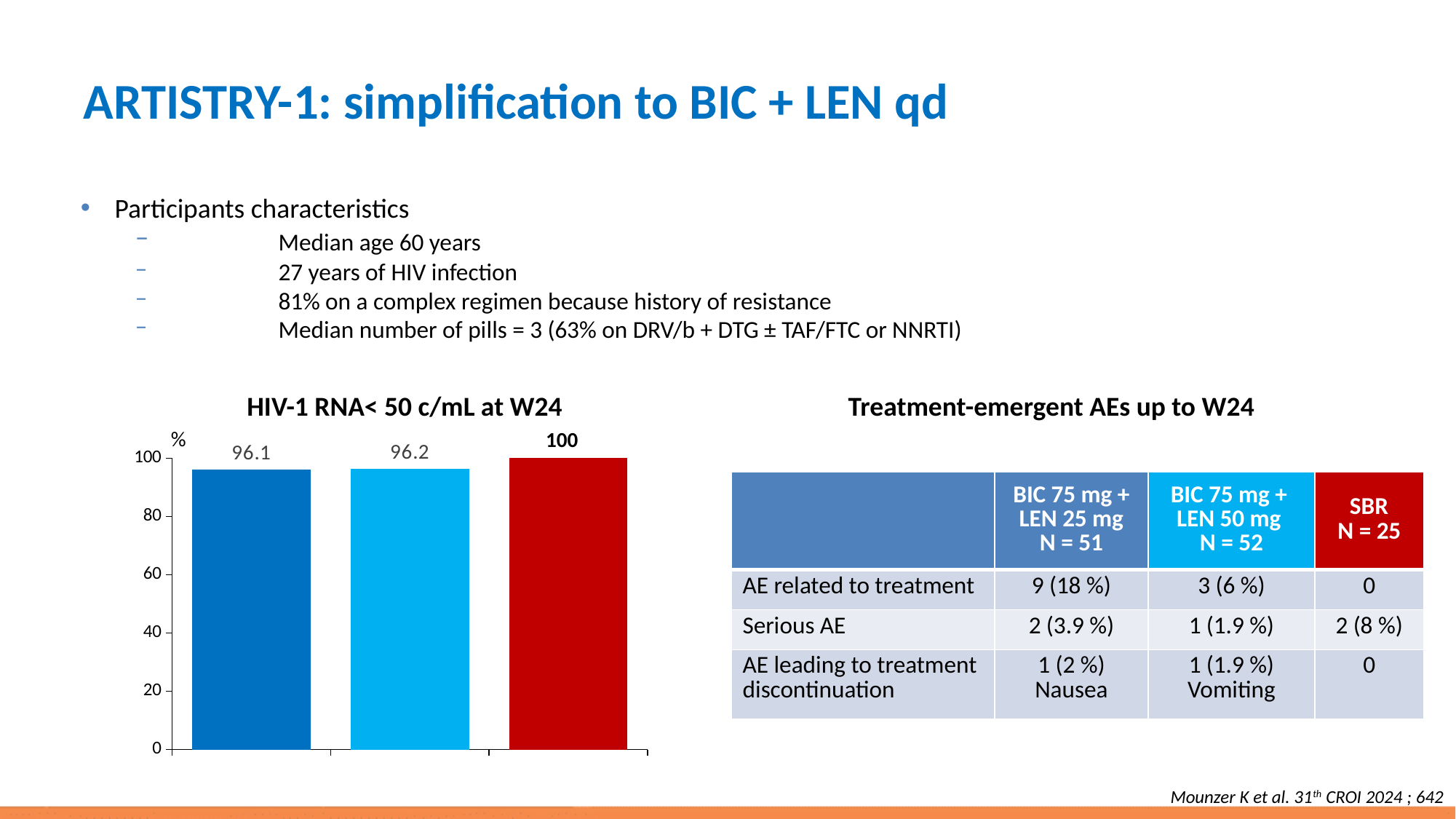
What kind of chart is shown under the title 'HIV-1 RNA< 50 c/mL at W24'? bar chart In the 'HIV-1 RNA< 50 c/mL at W24' chart, which bar has the highest value? the third (red) bar How many bars are plotted in the 'HIV-1 RNA< 50 c/mL at W24' chart? 3 In the 'HIV-1 RNA< 50 c/mL at W24' chart, is the value of the first bar greater or less than 80? greater In the 'HIV-1 RNA< 50 c/mL at W24' chart, which bar has the lowest value? the first (dark blue) bar What unit is shown on the y axis of the 'HIV-1 RNA< 50 c/mL at W24' chart? % In the 'HIV-1 RNA< 50 c/mL at W24' chart, what value is labelled on the first (dark blue) bar? 96.1 In the 'HIV-1 RNA< 50 c/mL at W24' chart, what is the difference between the red bar and the dark blue bar? 3.9 In the 'HIV-1 RNA< 50 c/mL at W24' chart, what value is labelled on the second (light blue) bar? 96.2 In the 'HIV-1 RNA< 50 c/mL at W24' chart, do the bar values rise or fall from left to right? rise In the 'HIV-1 RNA< 50 c/mL at W24' chart, which is larger: the red bar or the light blue bar? the red bar In the 'HIV-1 RNA< 50 c/mL at W24' chart, what value is labelled on the red bar? 100